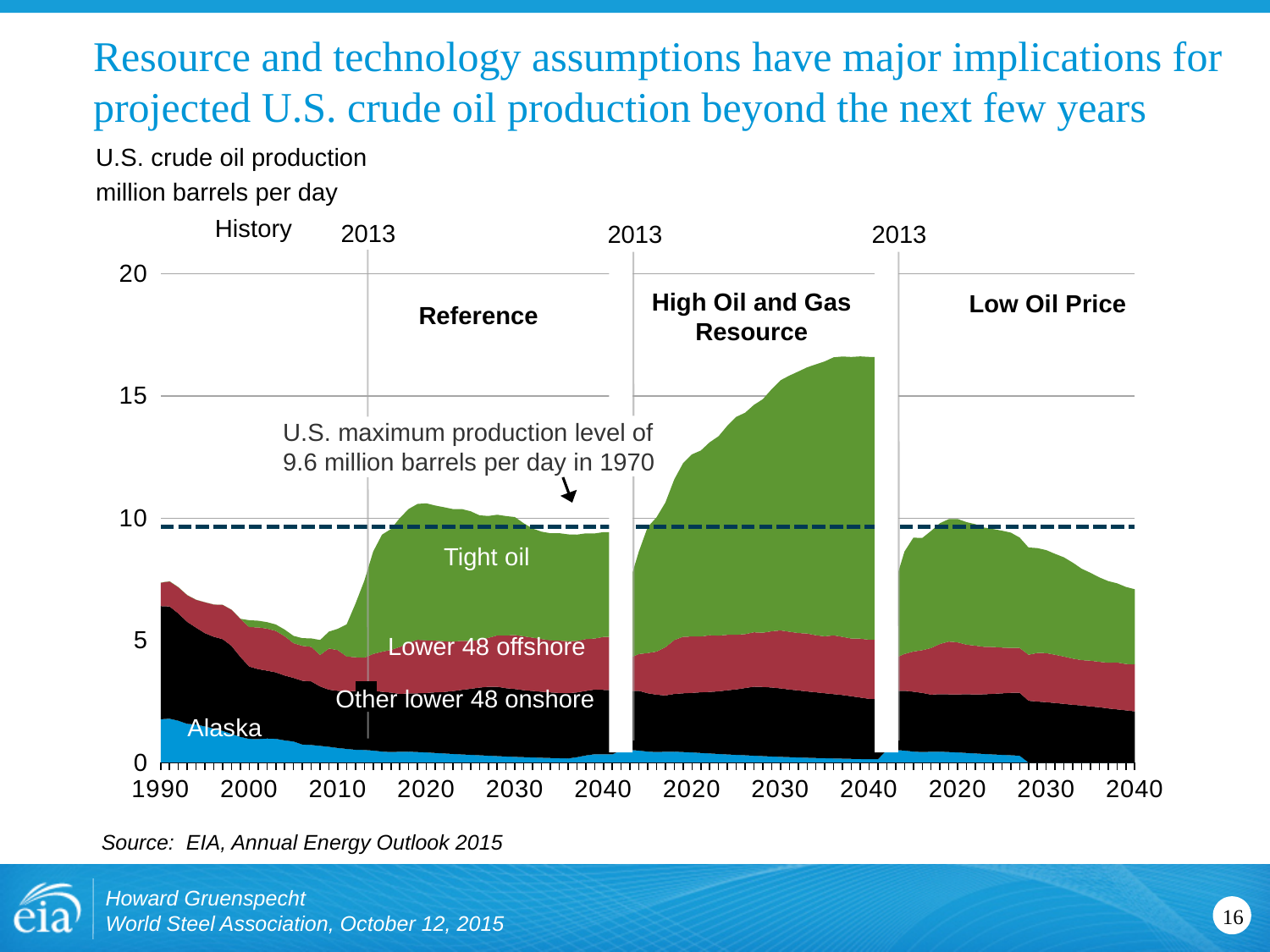
In the Low Oil Price scenario, does total production rise or fall between 2020 and 2040? fall What U.S. maximum production level in 1970 is marked by the dashed line in the chart? 9.6 million barrels per day How many projection scenarios are shown in the chart? 3 Which scenario shows the lowest total U.S. crude oil production in 2040? Low Oil Price How many production categories (stacked areas) are labeled in the chart? 4 In the Low Oil Price scenario, is total U.S. crude oil production in 2040 greater or less than 10 million barrels per day? less Which scenario shows the highest total U.S. crude oil production in 2040? High Oil and Gas Resource What unit is U.S. crude oil production measured in on the chart? million barrels per day What kind of chart is shown on the slide? Stacked area chart What are the names of the three projection scenarios shown in the chart? Reference, High Oil and Gas Resource, Low Oil Price In the High Oil and Gas Resource scenario, is total U.S. crude oil production in 2040 greater or less than 15 million barrels per day? greater In the Reference scenario, is total U.S. crude oil production in 2040 greater or less than 10 million barrels per day? less